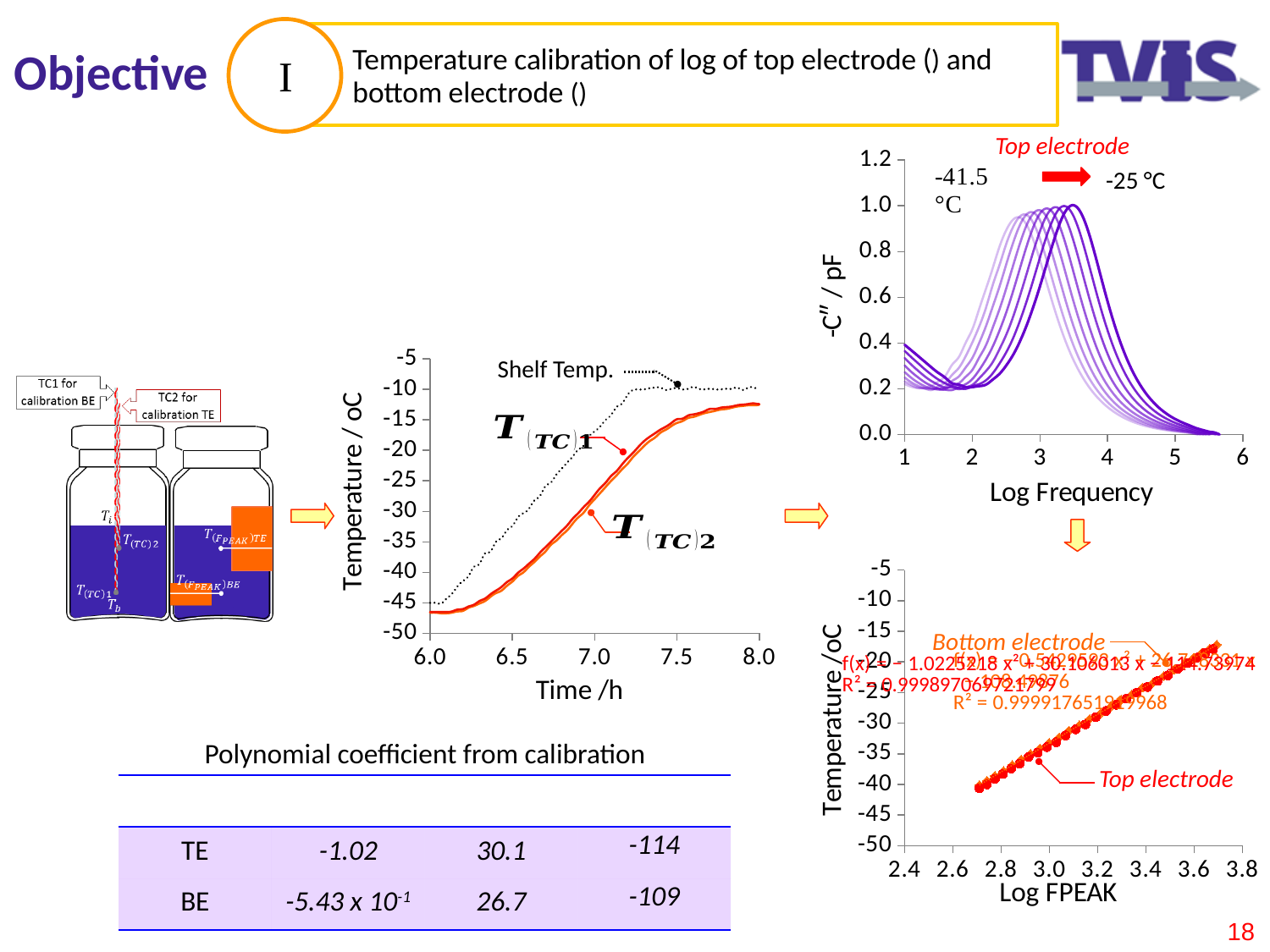
In the bottom-right chart of Temperature against Log FPEAK, is the temperature at Log FPEAK 2.7 greater or less than -35? less In the Temperature vs Time chart in the middle of the slide, what kind of chart is it? line chart In the Temperature vs Time chart in the middle of the slide, what is the label of the x axis? Time /h In the bottom-right chart of Temperature against Log FPEAK, how many series are labelled? 2 In the Temperature vs Time chart in the middle of the slide, is the T(TC)1 value at 6.0 h greater or less than -40? less In the top-right chart of -C'' / pF against Log Frequency, what temperature range do the curves span according to the annotation? -41.5 °C to -25 °C In the Temperature vs Time chart in the middle of the slide, do the temperatures rise or fall as time increases from 6.0 h to 8.0 h? rise In the Temperature vs Time chart in the middle of the slide, is the Shelf Temp. value at 7.5 h greater or less than -15? greater In the bottom-right chart of Temperature against Log FPEAK, does temperature rise or fall as Log FPEAK increases? rise In the Temperature vs Time chart in the middle of the slide, how many series are plotted? 3 In the top-right chart of -C'' / pF against Log Frequency, what is the maximum value shown on the y axis? 1.2